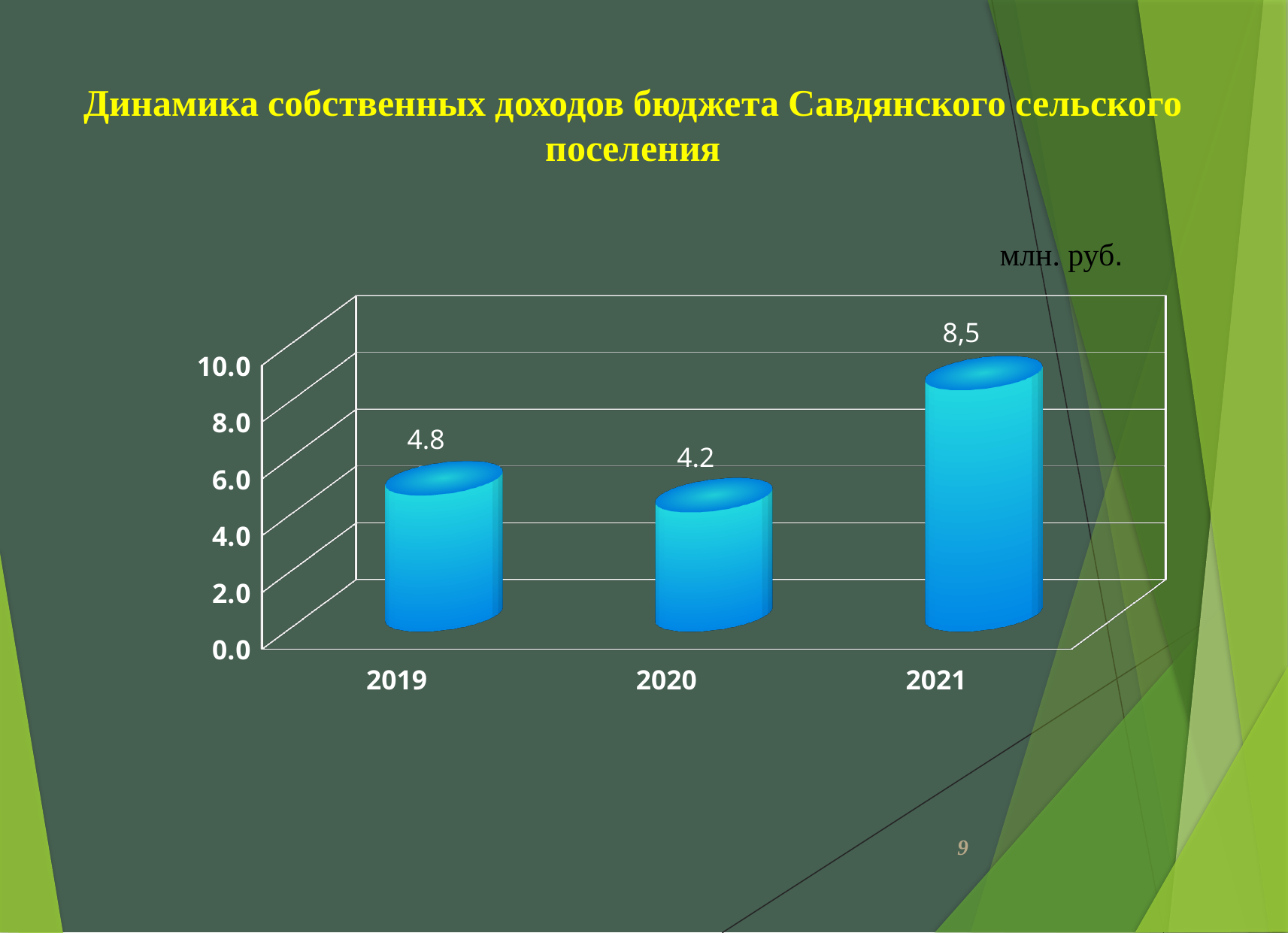
What kind of chart is shown on the slide? bar chart Does the value rise or fall from 2020 to 2021? rise Which is larger, the value for 2019 or the value for 2020? 2019 Is the value for 2021 greater or less than 6.0? greater Which year has the highest value? 2021 Which year has the lowest value? 2020 What is the difference between the values for 2019 and 2020? 0.6 What is the value for 2019? 4.8 What is the difference between the values for 2021 and 2020? 4.3 What is the value for 2020? 4.2 What is the value for 2021? 8,5 How many years are shown on the x axis? 3